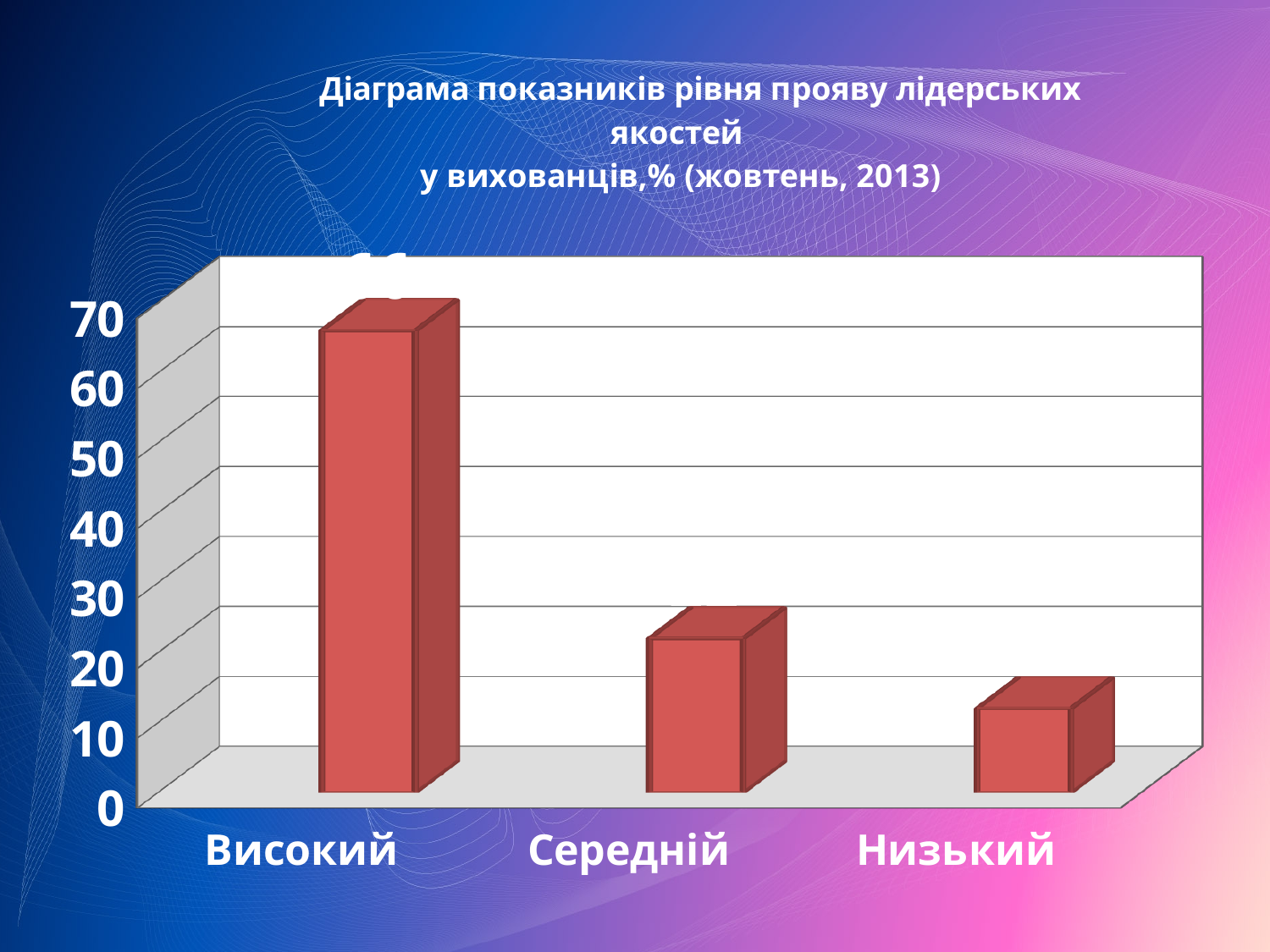
Which is larger, the value for Високий or the value for Середній? Високий Which category has the lowest bar in the chart? Низький Is the value for Середній greater or less than 30? less Which category has the highest bar in the chart? Високий Which is larger, the value for Середній or the value for Низький? Середній Is the value for Високий greater or less than 50? greater What kind of chart is shown on the slide? bar chart Do the bar values rise or fall from left to right along the x axis? fall Which month and year are given in the chart title? жовтень, 2013 Is the value for Низький greater or less than 20? less How many categories are shown on the x axis of the chart? 3